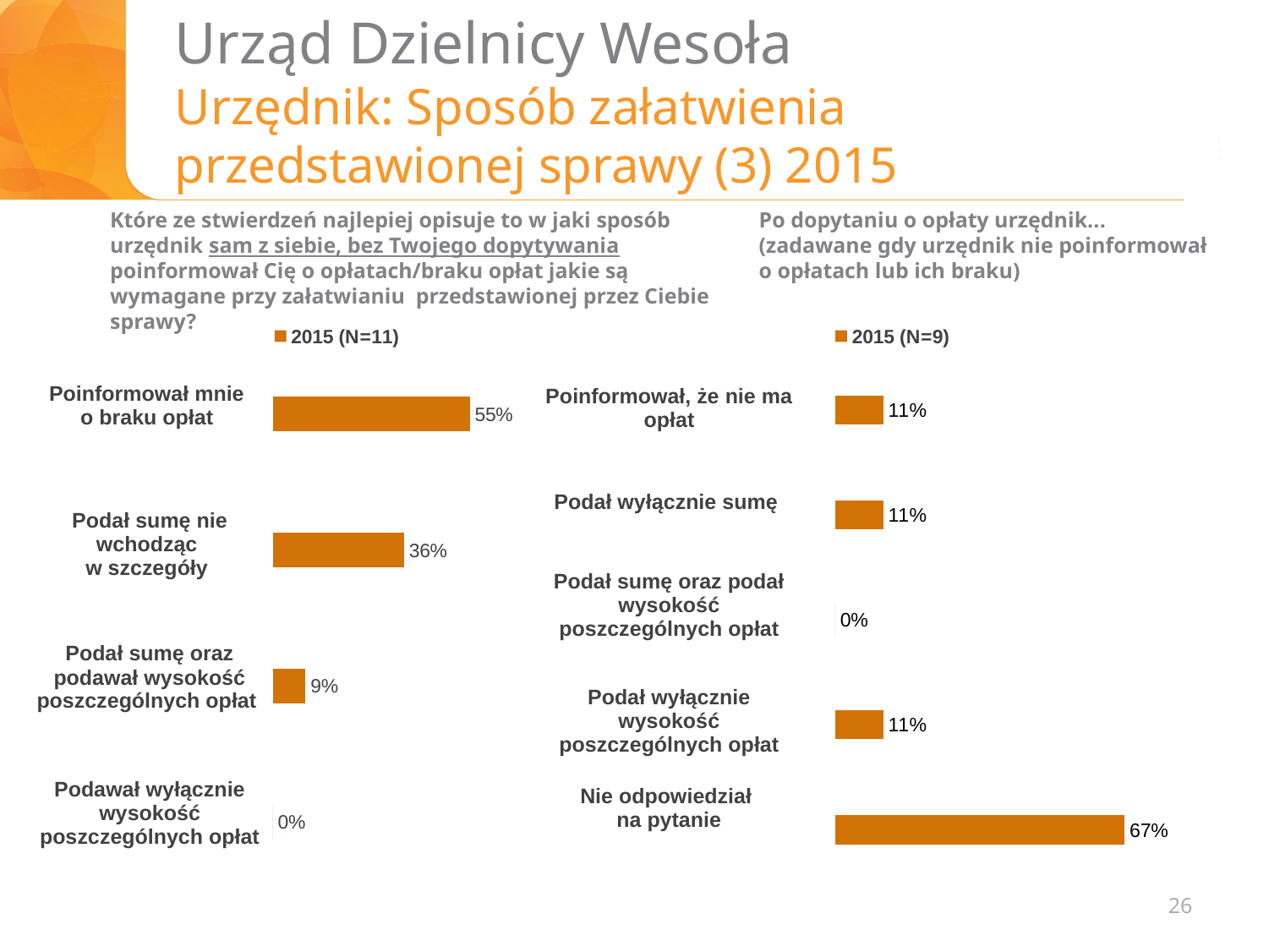
How many categories does the left chart show? 4 In the left chart, what is the difference between "Poinformował mnie o braku opłat" and "Podał sumę nie wchodząc w szczegóły"? 19% In the right chart, what is the value for "Podał sumę oraz podał wysokość poszczególnych opłat"? 0% In the left chart, what is the value for "Poinformował mnie o braku opłat"? 55% In the right chart, what is the value for "Nie odpowiedział na pytanie"? 67% In the left chart, which category has the lowest value? Podawał wyłącznie wysokość poszczególnych opłat In the right chart, which category has the highest value? Nie odpowiedział na pytanie What type of chart is the right chart? Bar chart In the left chart, which category has the highest value? Poinformował mnie o braku opłat In the right chart, which is larger: "Podał wyłącznie sumę" or "Nie odpowiedział na pytanie"? Nie odpowiedział na pytanie In the left chart, what is the value for "Podał sumę nie wchodząc w szczegóły"? 36% How many categories does the right chart show? 5